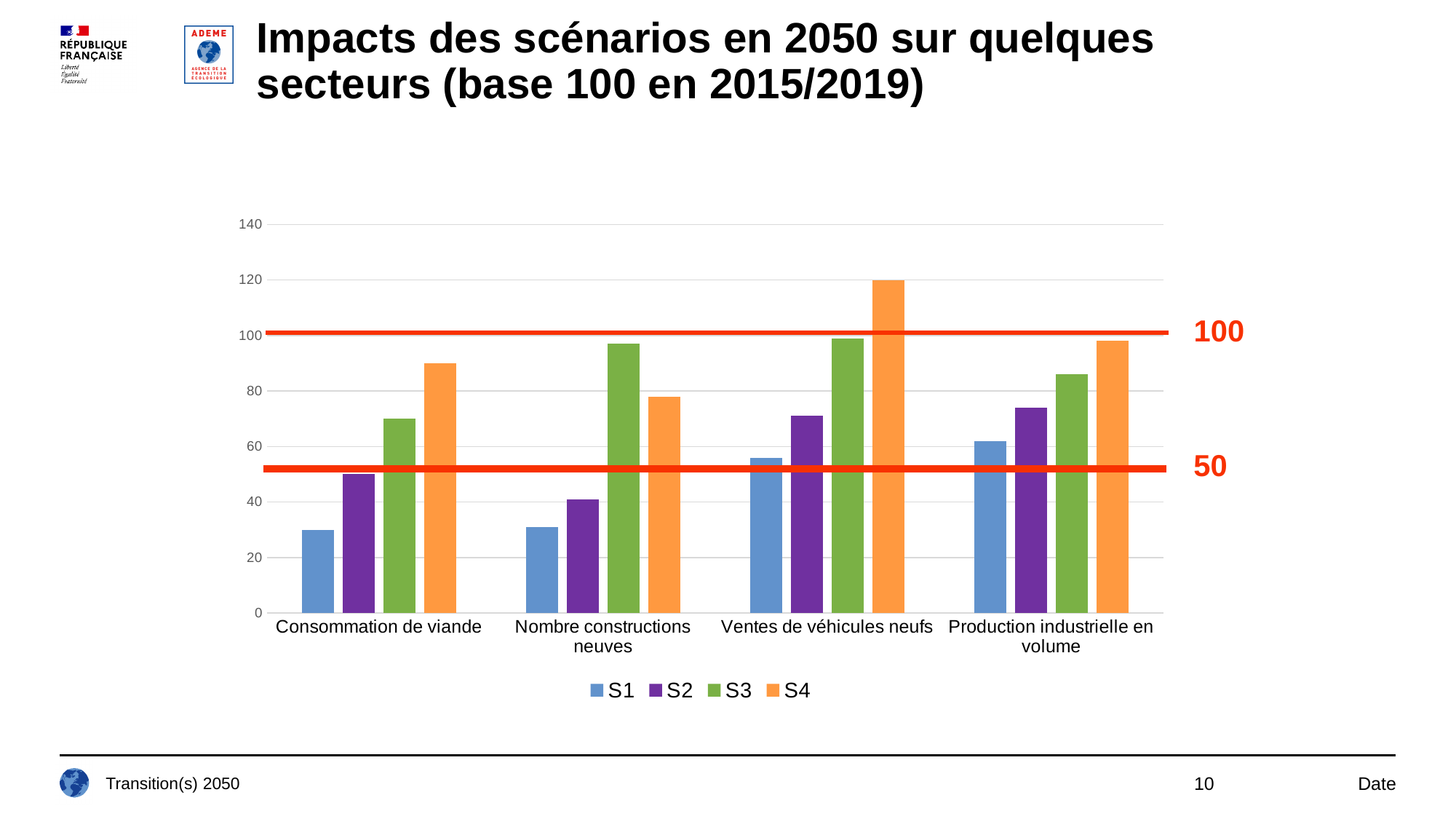
Which category has the tallest bar in the whole chart? Ventes de véhicules neufs Is the S1 value for Consommation de viande greater or less than 40? less Is the S4 value for Ventes de véhicules neufs greater or less than 100? greater Which series has the lowest bar for Ventes de véhicules neufs? S1 How many categories are shown on the x axis? 4 Which series has the highest bar for Consommation de viande? S4 What kind of chart is shown on the slide? bar chart What two values are marked by the red horizontal lines drawn across the chart? 100 and 50 How many series does the legend list? 4 Is the S3 value for Nombre constructions neuves greater or less than 80? greater Which is larger: the S4 value for Consommation de viande or the S4 value for Nombre constructions neuves? Consommation de viande Which series has the highest bar for Nombre constructions neuves? S3